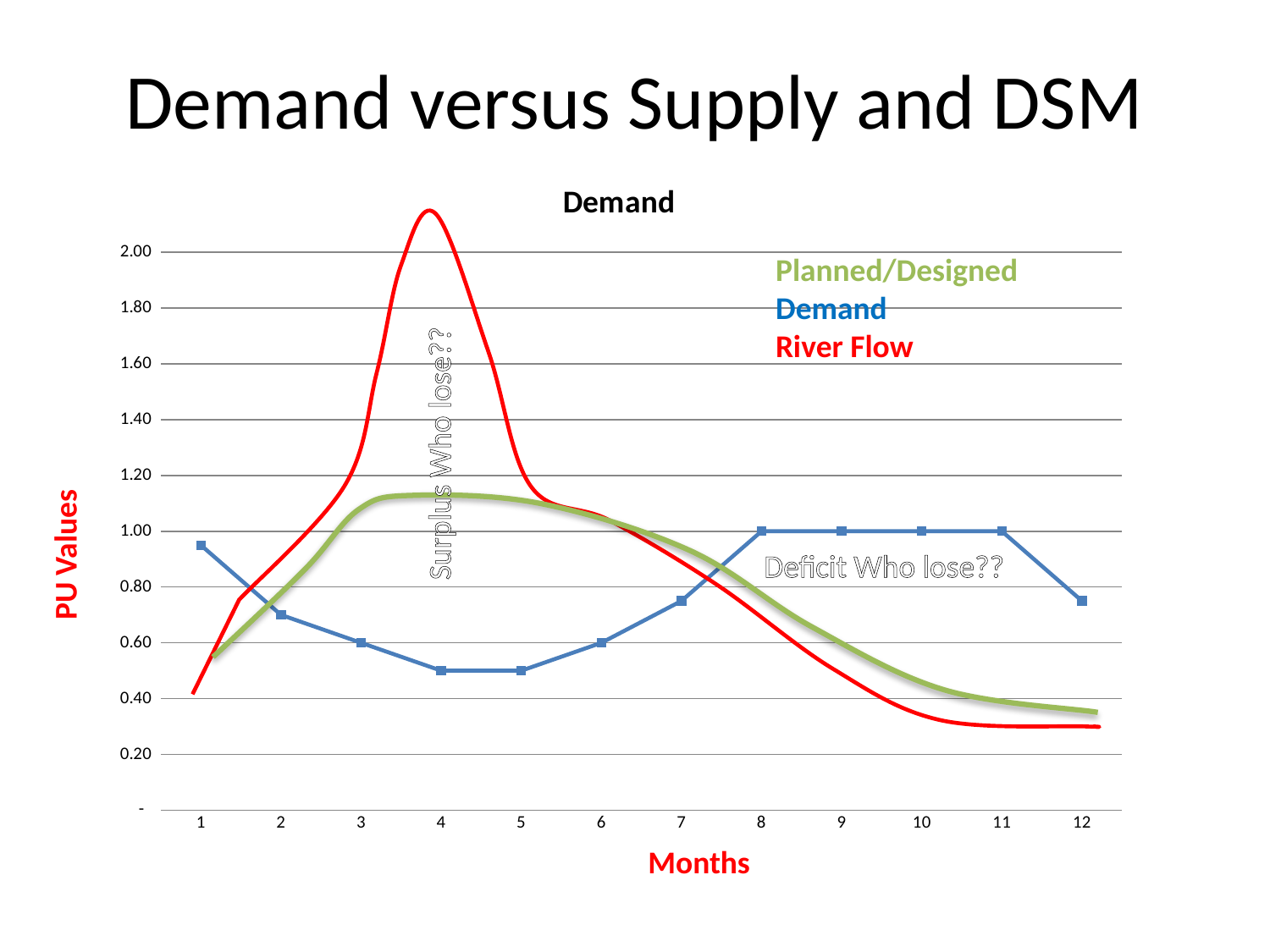
What is the Demand value at month 6? 0.60 How many series does the legend list? 3 Is the Planned/Designed value at month 4 greater or less than 1.00? greater Does River Flow rise or fall from month 4 to month 12? fall Is the River Flow value at month 4 greater or less than 2.00? greater What is the Demand value at month 3? 0.60 What kind of chart is shown on the slide? line chart What is the Demand value at month 8? 1.00 Is the River Flow value at month 12 greater or less than 0.40? less How many months are plotted along the x axis? 12 At which month does River Flow reach its highest value? 4 At month 10, which is larger: Demand or River Flow? Demand